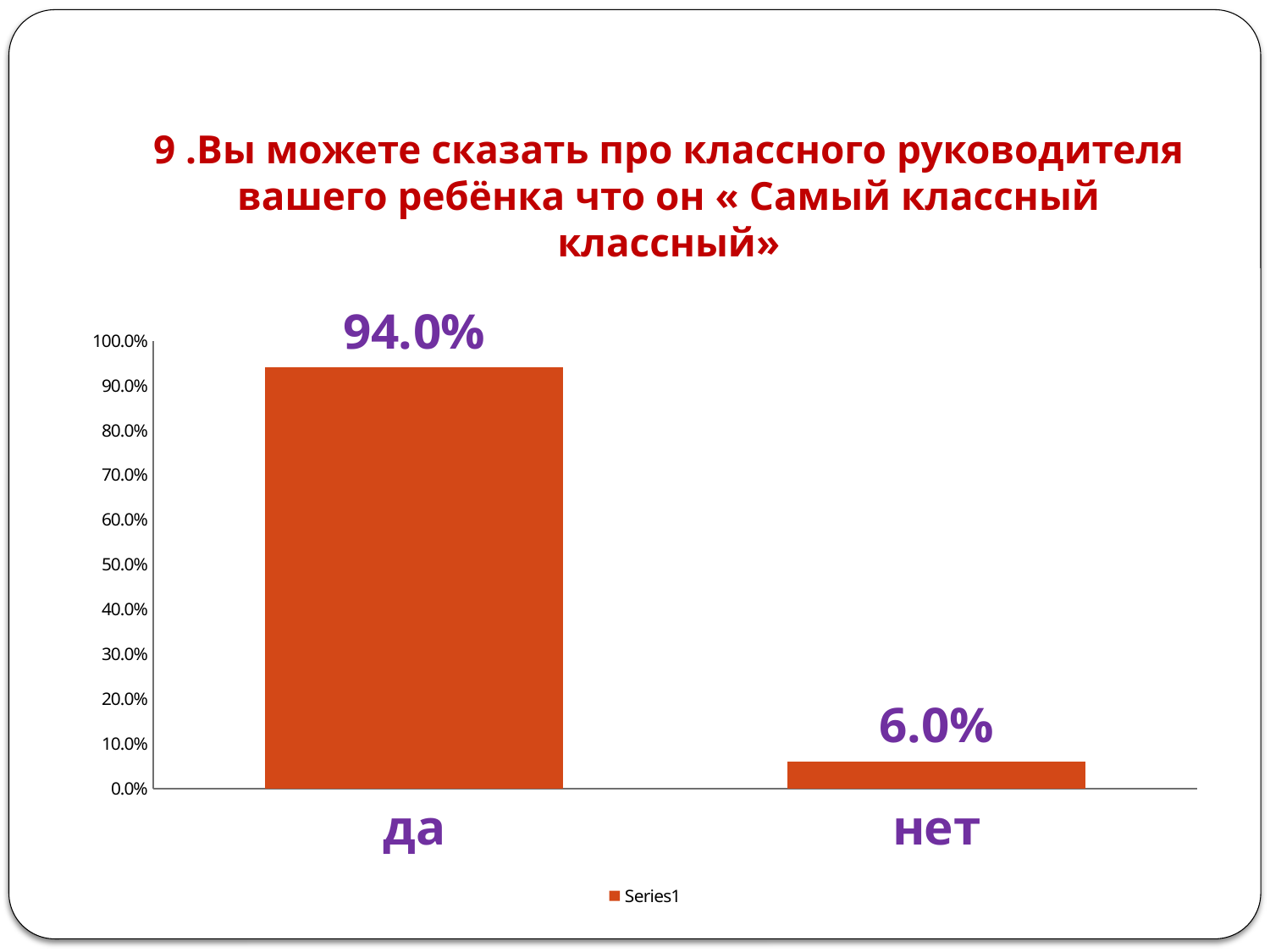
What is the value for "да"? 94.0% Is the value for "да" greater or less than 50.0%? greater Which category has the lowest value? нет What is the name of the series listed in the legend? Series1 How many categories are shown on the x axis? 2 Which category has the highest value? да What is the difference between the values for "да" and "нет"? 88.0% What kind of chart is shown on the slide? bar chart Which is larger, the value for "да" or the value for "нет"? да Is the value for "нет" greater or less than 10.0%? less What is the value for "нет"? 6.0% How many series does the legend list? 1